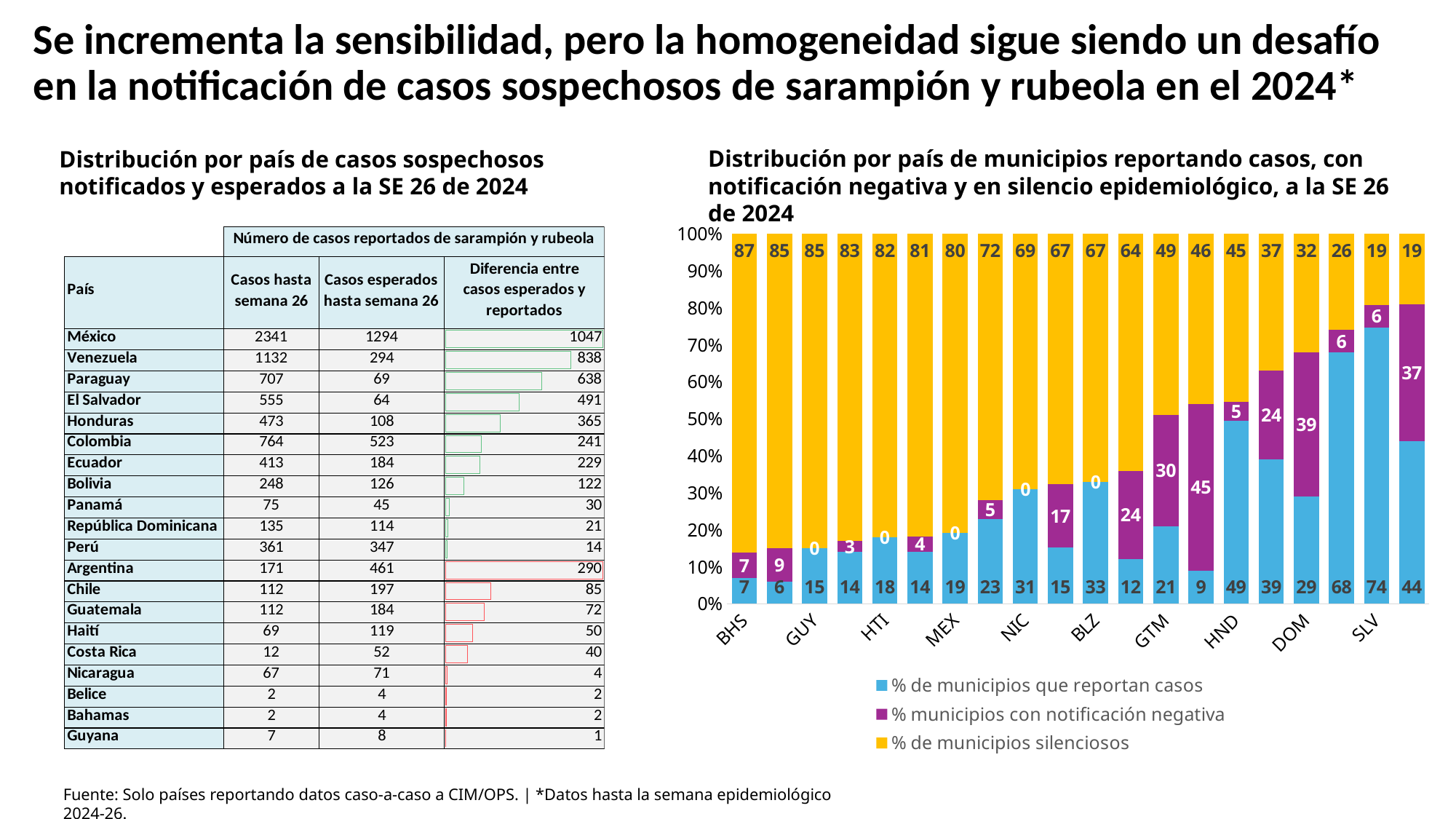
In the chart on the right, does the '% de municipios silenciosos' value generally rise or fall from left to right along the x axis? Fall In the stacked bar chart on the right, what is the value of '% municipios con notificación negativa' for DOM? 39 How many bars are plotted in the stacked bar chart on the right? 20 How many series does the legend of the chart on the right list? 3 In the stacked bar chart on the right, which labelled country has the highest value for '% de municipios silenciosos'? BHS In the stacked bar chart on the right, what is the difference between the '% de municipios que reportan casos' values for SLV and HND? 25 In the stacked bar chart on the right, which has a larger '% municipios con notificación negativa' value, DOM or GTM? DOM In the stacked bar chart on the right, what is the value of '% de municipios silenciosos' for BHS? 87 In the stacked bar chart on the right, what is the value of '% de municipios que reportan casos' for SLV? 74 In the stacked bar chart on the right, which labelled country has the highest value for '% de municipios que reportan casos'? SLV What kind of chart is shown on the right side of the slide? Stacked bar chart In the stacked bar chart on the right, what is the value of '% municipios con notificación negativa' for GTM? 30